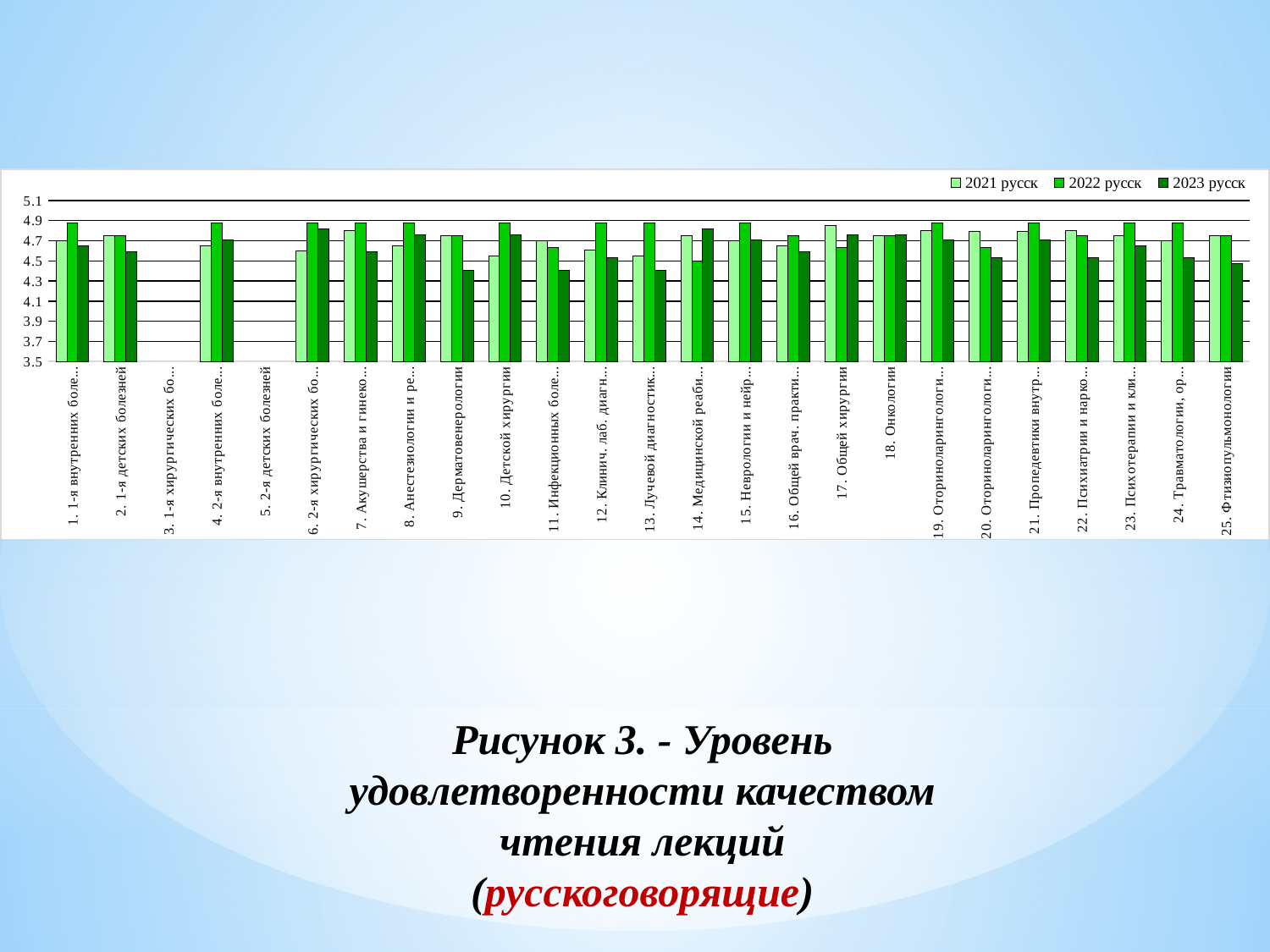
For 14. Медицинской реаби..., which is larger: the 2022 русск value or the 2023 русск value? 2023 русск How many numbered categories are shown on the x axis? 25 What kind of chart is shown on the slide? bar chart What are the three series listed in the legend? 2021 русск, 2022 русск, 2023 русск Is the 2023 русск value for 18. Онкологии greater or less than 4.5? greater Is the 2023 русск value for 9. Дерматовенерологии greater or less than 4.7? less Which two numbered categories have no bars plotted? 3 and 5 For 1. 1-я внутренних боле..., which is larger: the 2022 русск value or the 2023 русск value? 2022 русск How many series does the legend list? 3 Is the 2022 русск value for 10. Детской хирургии greater or less than 4.7? greater